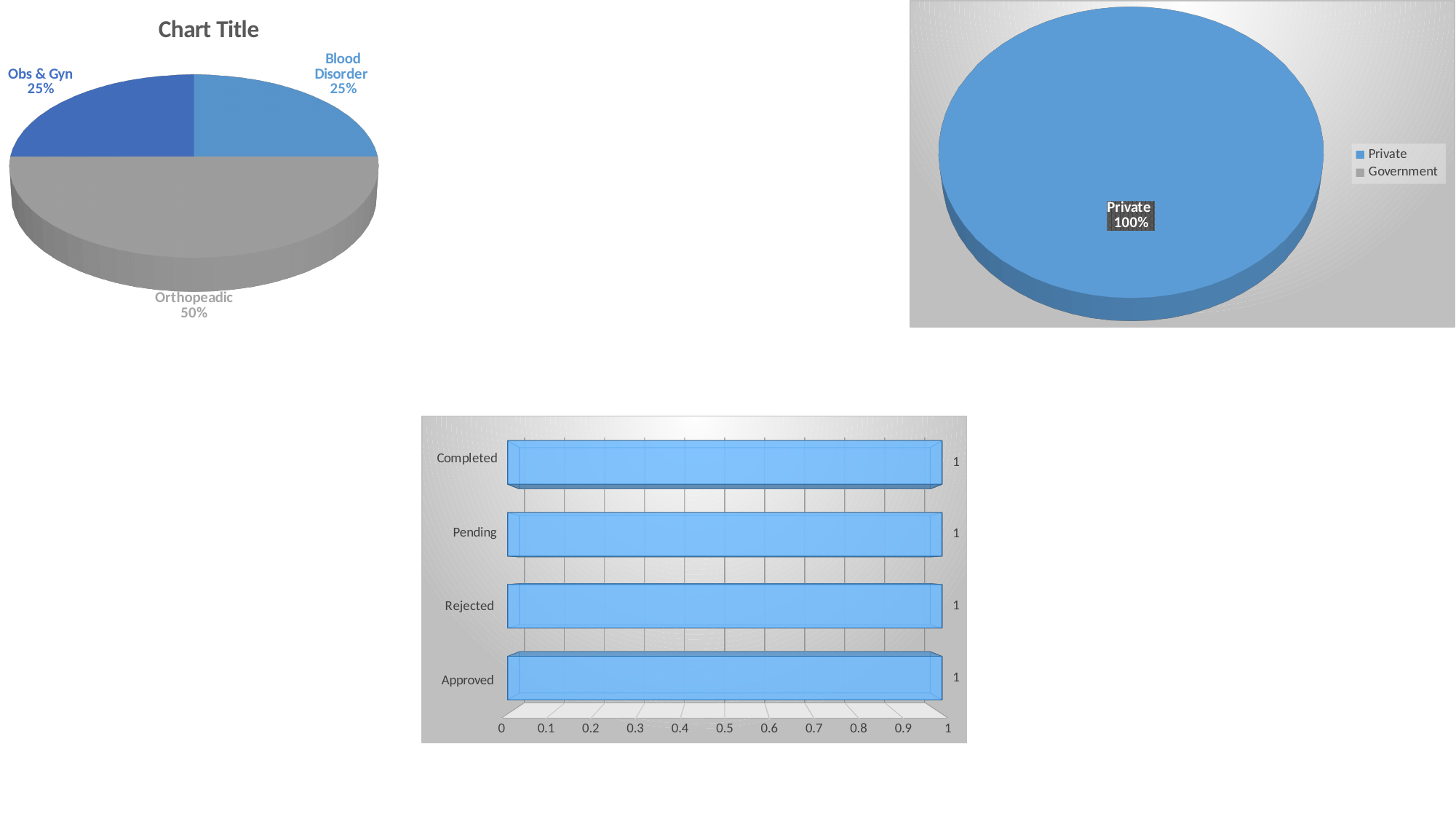
What kind of chart is the top-left chart titled "Chart Title"? Pie chart In the top-left pie chart titled "Chart Title", which category has the largest slice? Orthopeadic In the top-left pie chart titled "Chart Title", how many slices are there? 3 In the bottom bar chart, what is the value for Pending? 1 In the top-left pie chart titled "Chart Title", what share does Obs & Gyn have? 25% What kind of chart is the bottom chart? Bar chart In the top-right pie chart, what share does Private have? 100% In the top-left pie chart titled "Chart Title", what share does Orthopeadic have? 50% In the top-right pie chart, how many entries does the legend list? 2 In the top-right pie chart, which legend entry is shown in grey? Government In the bottom bar chart, how many categories are shown? 4 In the top-left pie chart titled "Chart Title", what is the difference between the Orthopeadic share and the Blood Disorder share? 25%